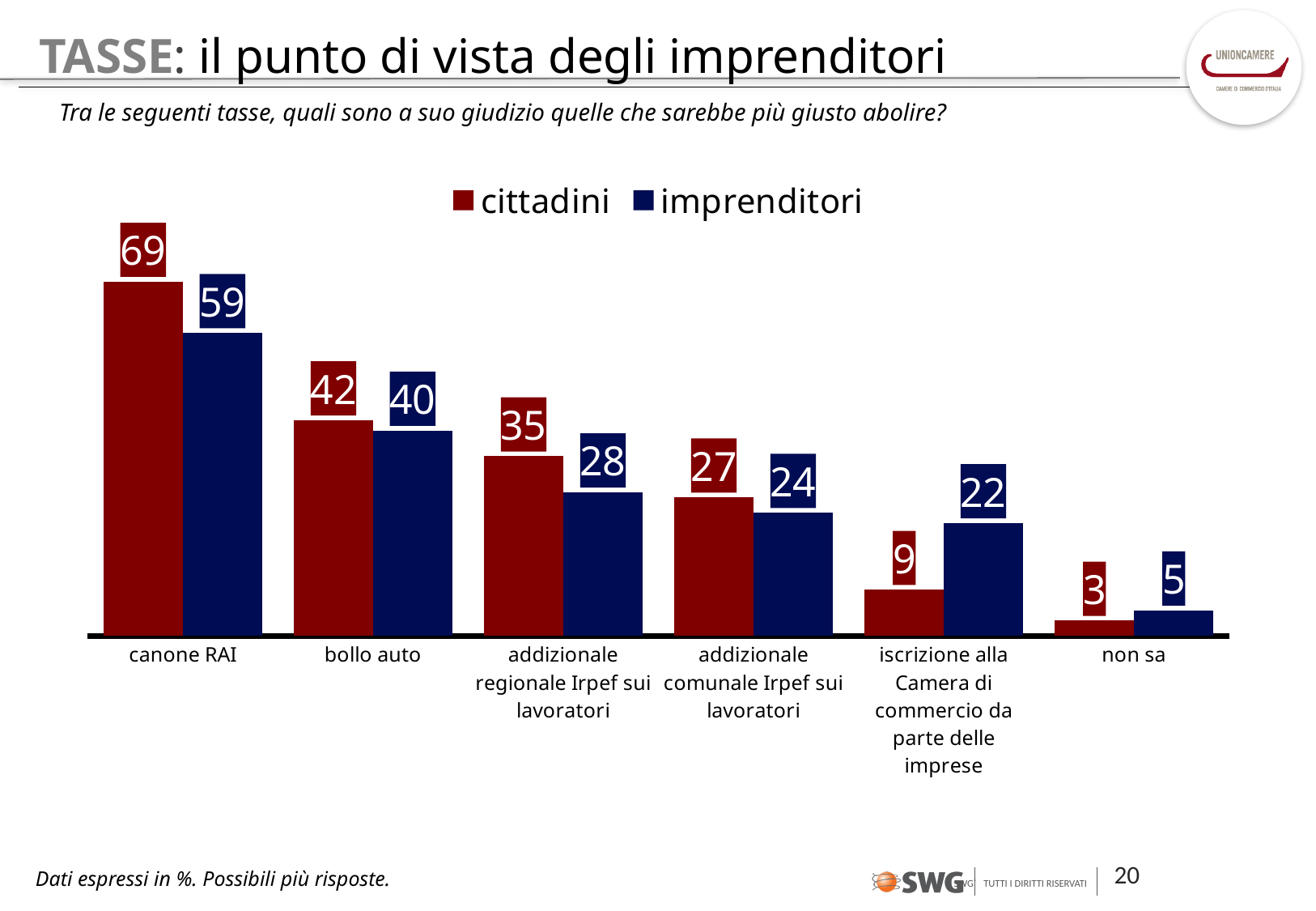
Which colour represents the imprenditori series? dark blue What is the value for imprenditori for bollo auto? 40 What is the difference between the imprenditori and cittadini values for iscrizione alla Camera di commercio da parte delle imprese? 13 Which is larger for addizionale regionale Irpef sui lavoratori: cittadini or imprenditori? cittadini What is the value for cittadini for canone RAI? 69 What kind of chart is shown on the slide? bar chart Which category has the highest value for imprenditori? canone RAI What is the difference between the cittadini and imprenditori values for canone RAI? 10 How many categories are shown on the x axis? 6 What is the value for imprenditori for iscrizione alla Camera di commercio da parte delle imprese? 22 How many series does the legend list? 2 Which category has the lowest value for cittadini? non sa